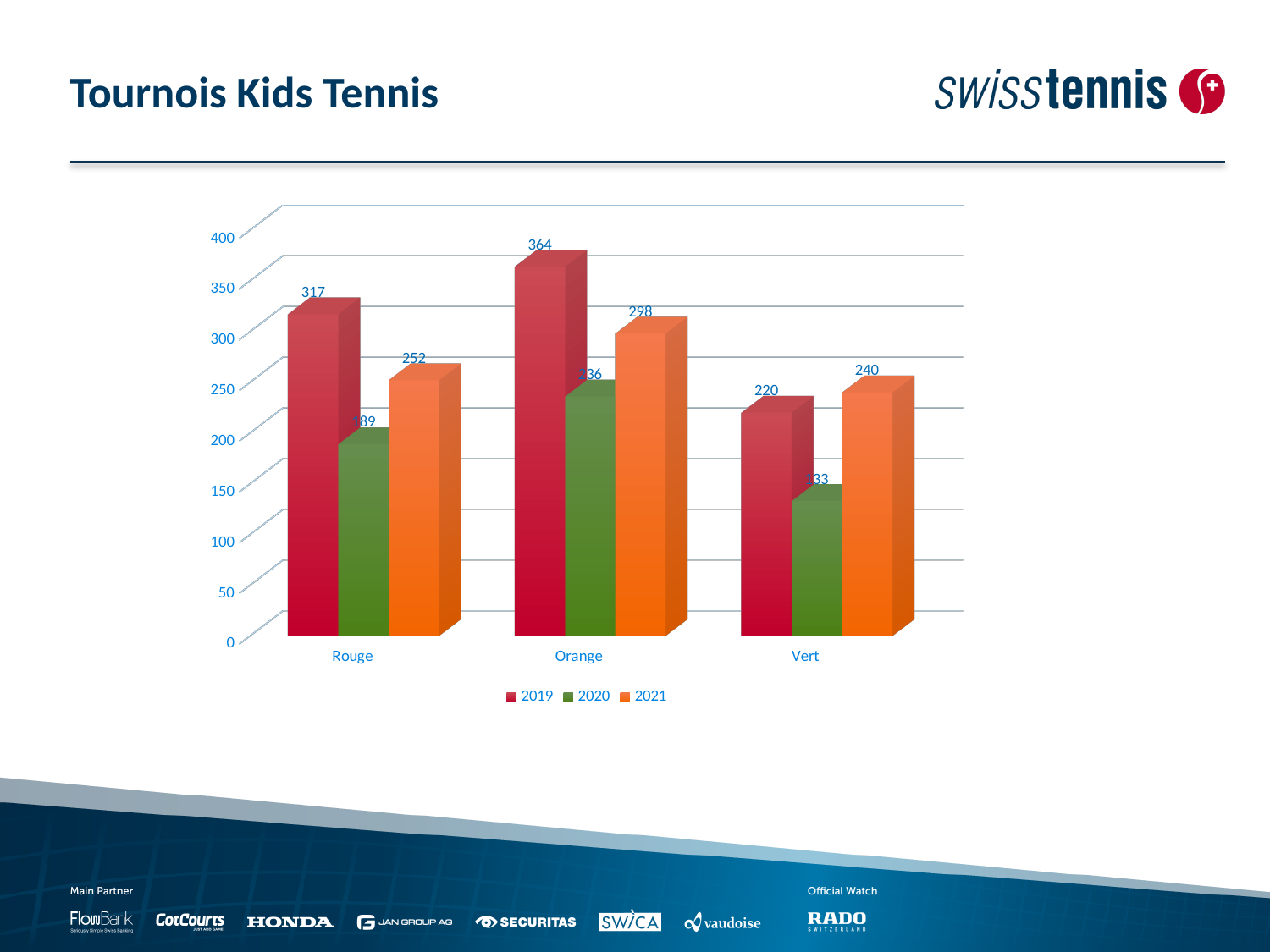
What kind of chart is shown on the slide? bar chart What is the difference between the 2019 values for Orange and Rouge? 47 What is the value for Orange in 2021? 298 How many categories are shown on the x axis? 3 Which is larger for Vert: the 2019 value or the 2021 value? 2021 How many series does the legend list? 3 What is the value for Vert in 2019? 220 Which category has the highest 2019 value? Orange Which category has the lowest 2021 value? Vert What is the value for Rouge in 2021? 252 What is the value for Rouge in 2019? 317 Is the 2020 value for Vert greater or less than 150? less